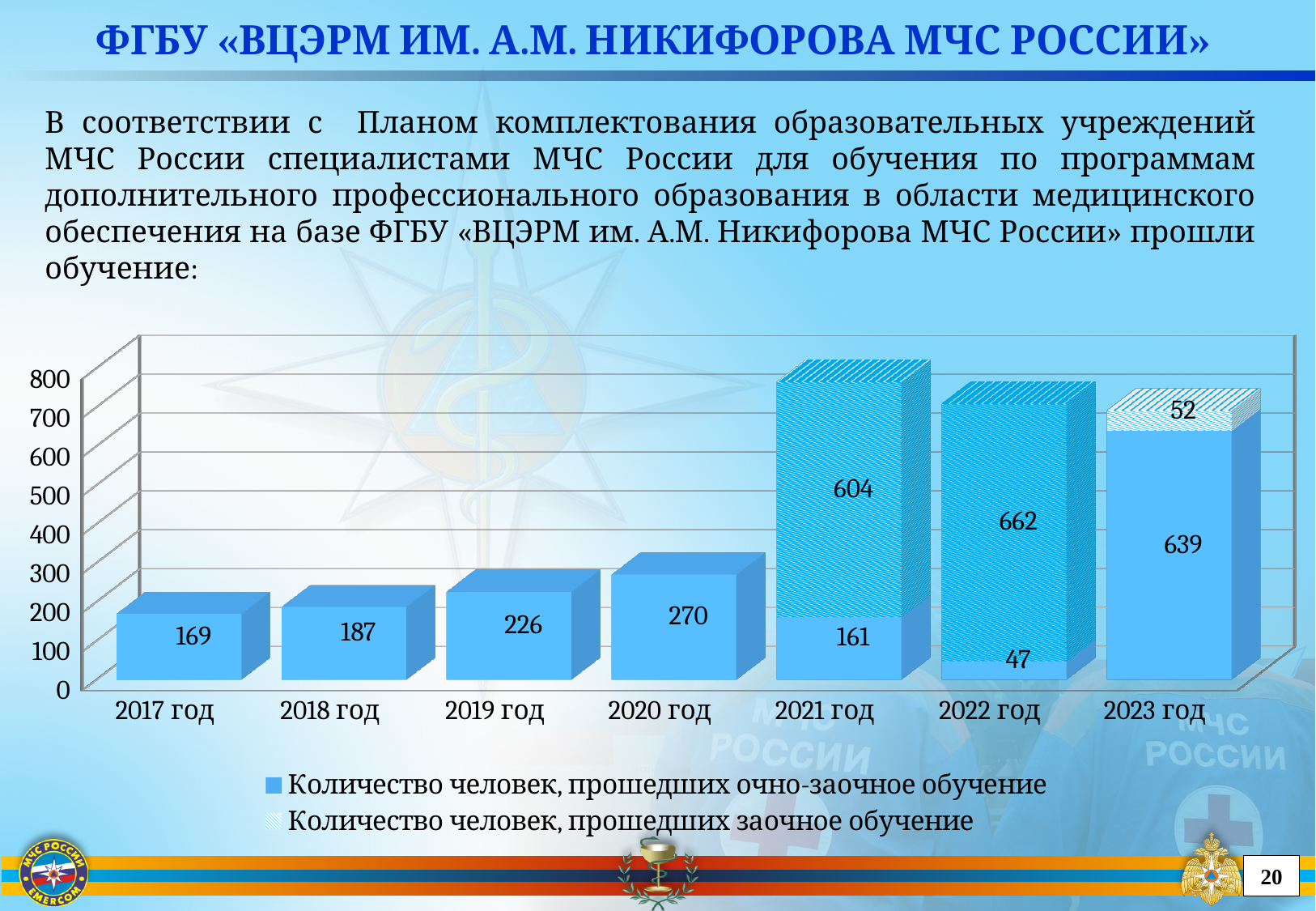
How many series does the legend list? 2 What is the total of the stacked bar for 2023 год? 691 What is the total of the stacked bar for 2021 год? 765 What is the difference between the 2020 год and 2017 год values for the series 'Количество человек, прошедших очно-заочное обучение'? 101 Which year has the lowest value for the series 'Количество человек, прошедших очно-заочное обучение'? 2022 год How many years are shown on the x axis? 7 What is the value for 2017 год for the series 'Количество человек, прошедших очно-заочное обучение'? 169 Which is larger for the series 'Количество человек, прошедших очно-заочное обучение': 2019 год or 2023 год? 2023 год What is the value for 2021 год for the series 'Количество человек, прошедших заочное обучение'? 604 Which year has the highest value for the series 'Количество человек, прошедших заочное обучение'? 2022 год What is the value for 2022 год for the series 'Количество человек, прошедших очно-заочное обучение'? 47 What is the value for 2023 год for the series 'Количество человек, прошедших заочное обучение'? 52